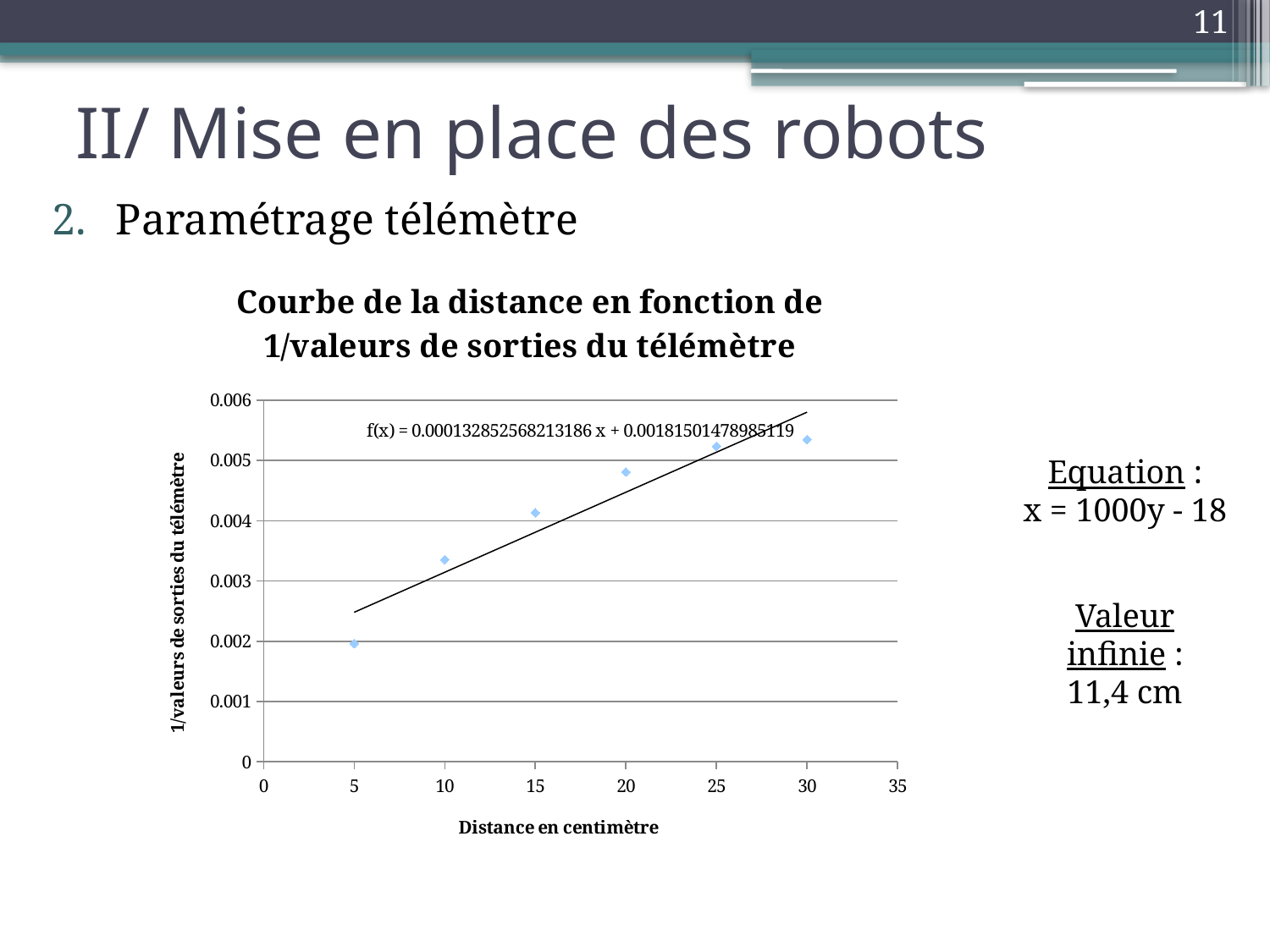
Is the plotted value at a distance of 25 cm greater or less than 0.005? greater At which distance in centimetres is the plotted value lowest? 5 What kind of chart is shown on the slide? scatter chart Is the plotted value at a distance of 5 cm greater or less than 0.003? less Do the plotted values rise or fall as the distance increases along the x axis? rise What is the title of the chart? Courbe de la distance en fonction de 1/valeurs de sorties du télémètre Is the plotted value at a distance of 15 cm greater or less than 0.005? less What is the label of the x axis of the chart? Distance en centimètre How many data points are plotted on the chart? 6 Which has the larger plotted value: the point at 10 cm or the point at 20 cm? 20 cm